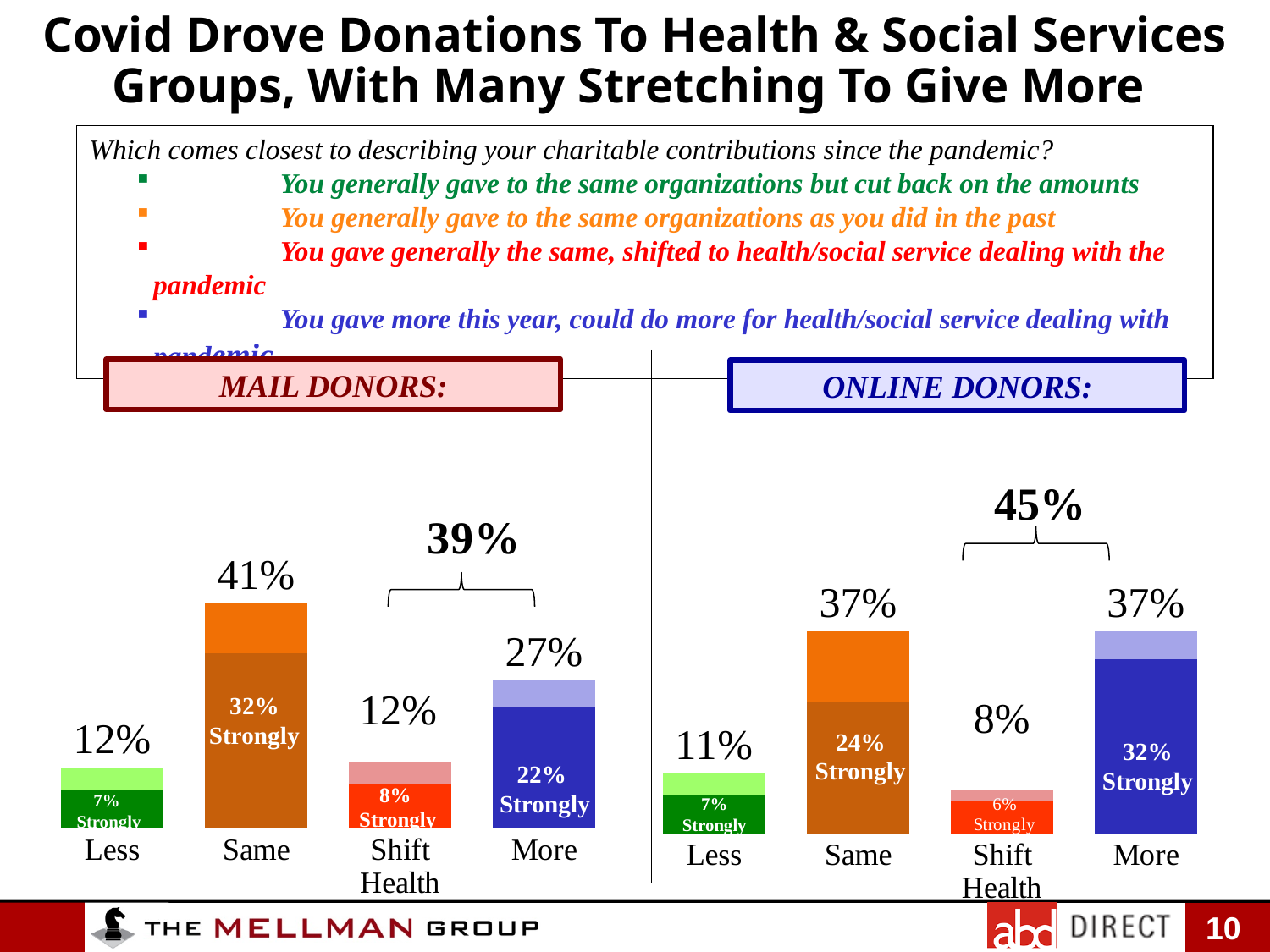
In the Mail Donors chart, what percentage is shown for the Same category? 41% How many categories are shown on the x axis of the Online Donors chart? 4 In the Mail Donors chart, what is the 'Strongly' percentage within the More bar? 22% In the Online Donors chart, what is the 'Strongly' percentage within the Same bar? 24% In the Online Donors chart, what percentage is shown for the More category? 37% In the Online Donors chart, what is the difference between the Less and Shift Health percentages? 3% Which is larger in the Mail Donors chart: the percentage for Less or the percentage for More? More In the Mail Donors chart, which category has the highest percentage? Same In the Online Donors chart, what combined percentage is shown by the bracket above Shift Health and More? 45% In the Mail Donors chart, what is the difference between the Same and More percentages? 14% What kind of chart is used for the Mail Donors data? Bar chart In the Online Donors chart, which category has the lowest percentage? Shift Health